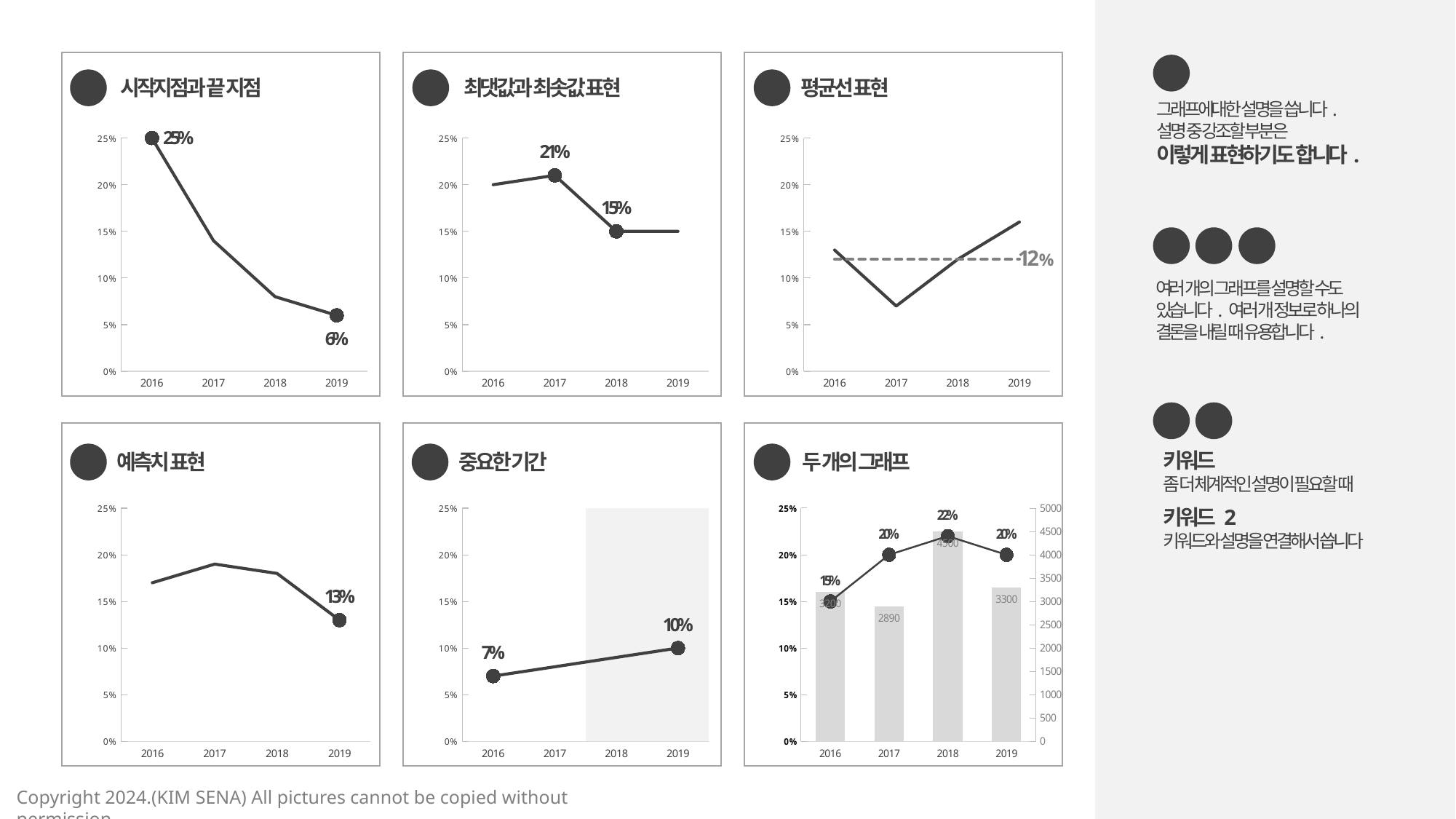
In the top-right chart (평균선 표현), is the value for 2017 greater or less than 10%? less In the bottom-left chart (예측치 표현), what is the value for 2019? 13% In the top-left chart (시작지점과 끝 지점), what is the value for 2016? 25% In the bottom-right chart (두 개의 그래프), what is the bar value for 2018? 4500 In the top-middle chart (최댓값과 최솟값 표현), what is the value for 2017? 21% In the top-middle chart (최댓값과 최솟값 표현), what is the value for 2018? 15% How many years are shown on the x axis of the bottom-right chart (두 개의 그래프)? 4 In the bottom-right chart (두 개의 그래프), which year has the lowest bar? 2017 In the top-left chart (시작지점과 끝 지점), what is the value for 2019? 6% In the top-left chart (시작지점과 끝 지점), do the values rise or fall from 2016 to 2019? fall In the bottom-middle chart (중요한 기간), what is the difference between the 2019 value and the 2016 value? 3% In the top-right chart (평균선 표현), what value is marked by the dashed average line? 12%